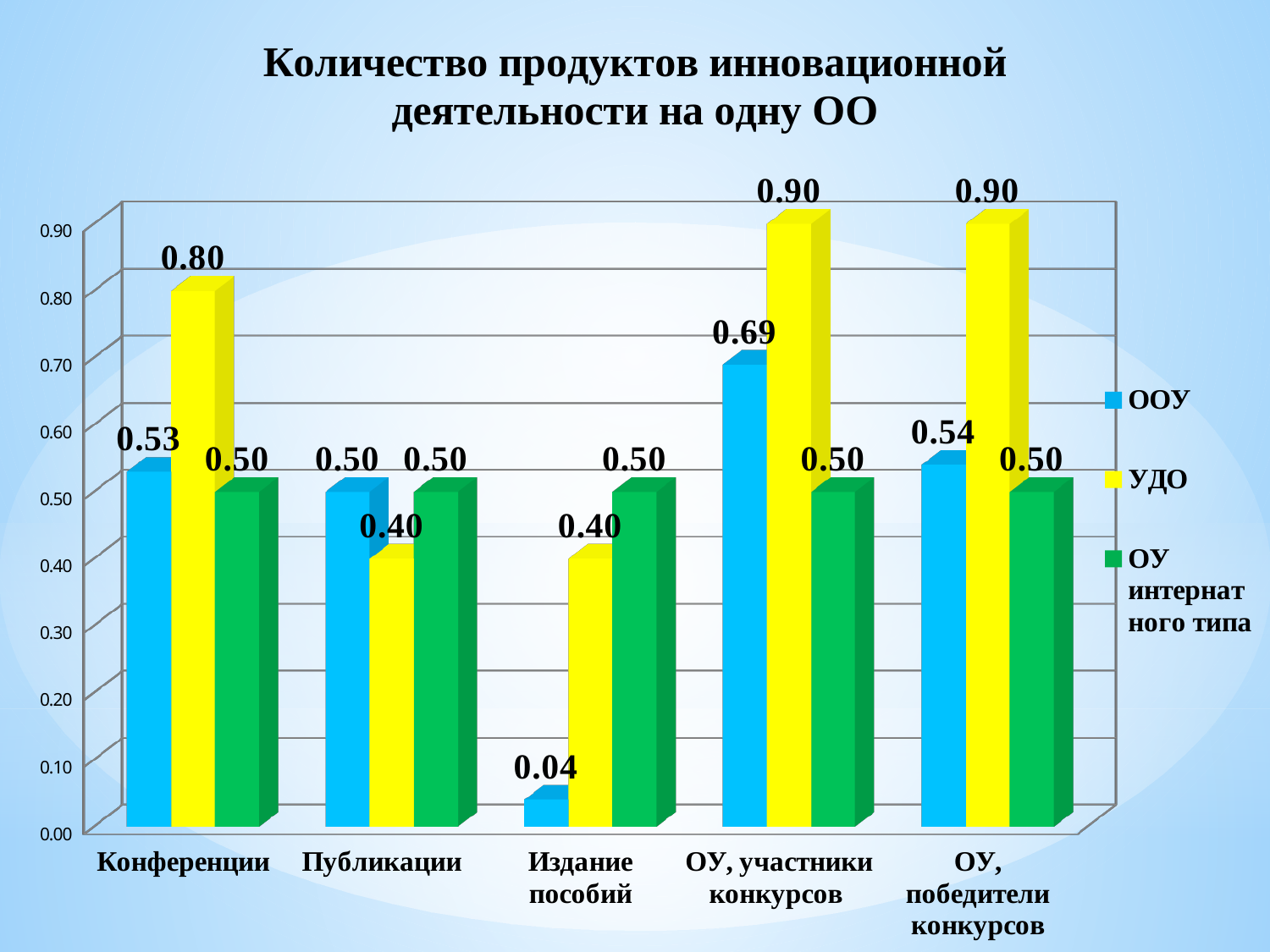
Which is larger in the Публикации category: the ООУ value or the УДО value? ООУ How many categories are shown on the x axis? 5 What is the value for ОУ интернатного типа in the ОУ, победители конкурсов category? 0.50 In which category does the ООУ series have its lowest value? Издание пособий What kind of chart is shown on the slide? Bar chart What is the difference between the УДО value and the ООУ value in the Конференции category? 0.27 What is the value for ООУ in the Конференции category? 0.53 What is the value for ООУ in the Издание пособий category? 0.04 In which category does the ООУ series have its highest value? ОУ, участники конкурсов What colour are the bars for the УДО series? Yellow What is the value for УДО in the Издание пособий category? 0.40 How many series does the legend list? 3